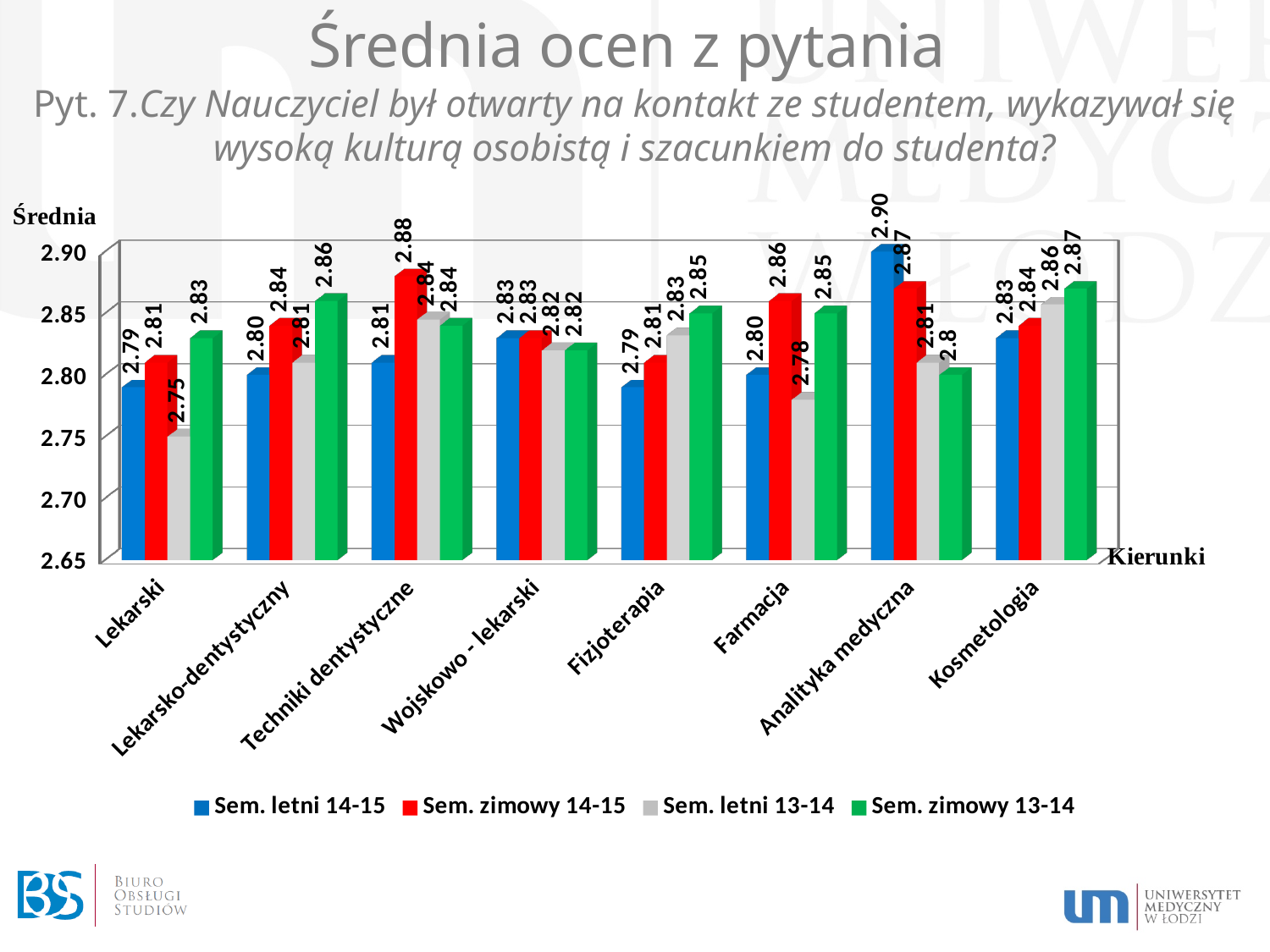
For Fizjoterapia, which is larger: the Sem. letni 14-15 value or the Sem. zimowy 13-14 value? Sem. zimowy 13-14 Which category has the highest value in the Sem. letni 14-15 series? Analityka medyczna How many categories (kierunki) are shown on the x axis? 8 What kind of chart is shown on the slide? Bar chart How many series does the legend list? 4 What is the value for Techniki dentystyczne in the Sem. zimowy 14-15 series? 2.88 Which category has the lowest value in the Sem. letni 13-14 series? Lekarski What is the difference between the Sem. zimowy 14-15 and Sem. letni 13-14 values for Farmacja? 0.08 Which series is shown in red in the legend? Sem. zimowy 14-15 What is the value for Lekarski in the Sem. letni 13-14 series? 2.75 What is the value for Kosmetologia in the Sem. zimowy 13-14 series? 2.87 What is the value for Analityka medyczna in the Sem. letni 14-15 series? 2.90